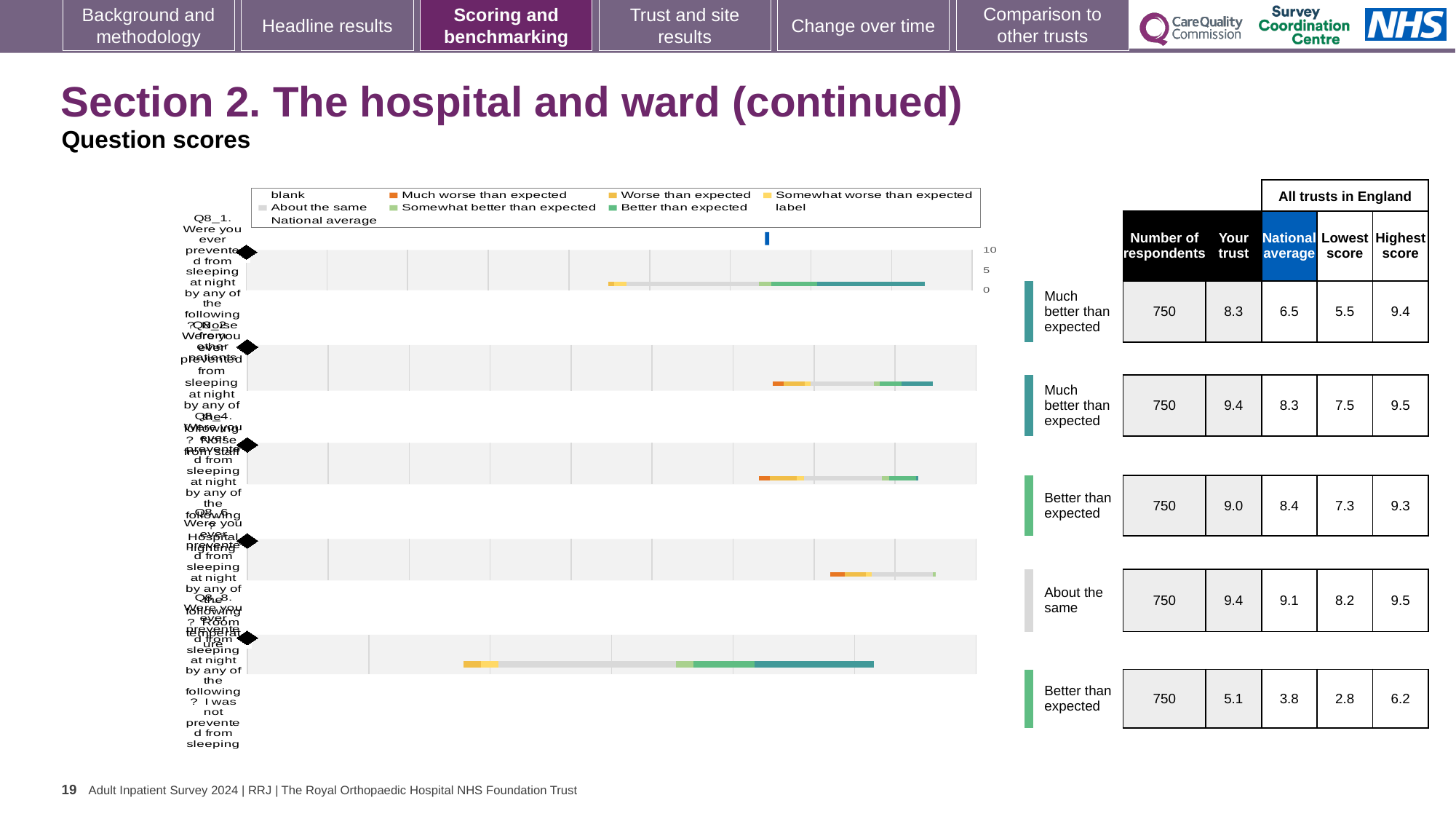
In the table beside the chart, what is the highest score for the third row (Q8_4)? 9.3 How many question rows (bars) does the chart show? 5 For the first row (Q8_1), what is the difference between the 'Your trust' score and the national average? 1.8 For the last row (Q8_8), what is the difference between the highest score and the lowest score? 3.4 In the table beside the chart, what is the 'Your trust' score for the first row (Q8_1)? 8.3 For the first row (Q8_1), which is larger: the 'Your trust' score or the national average? Your trust What benchmark label is shown for the last row (Q8_8)? Better than expected In the table beside the chart, what is the national average for the last row (Q8_8)? 3.8 What kind of chart is shown on the slide? bar chart What benchmark label is shown for the first row (Q8_1)? Much better than expected What is the lowest 'Your trust' score shown in the table beside the chart? 5.1 How many respondents are listed for each question row in the table? 750